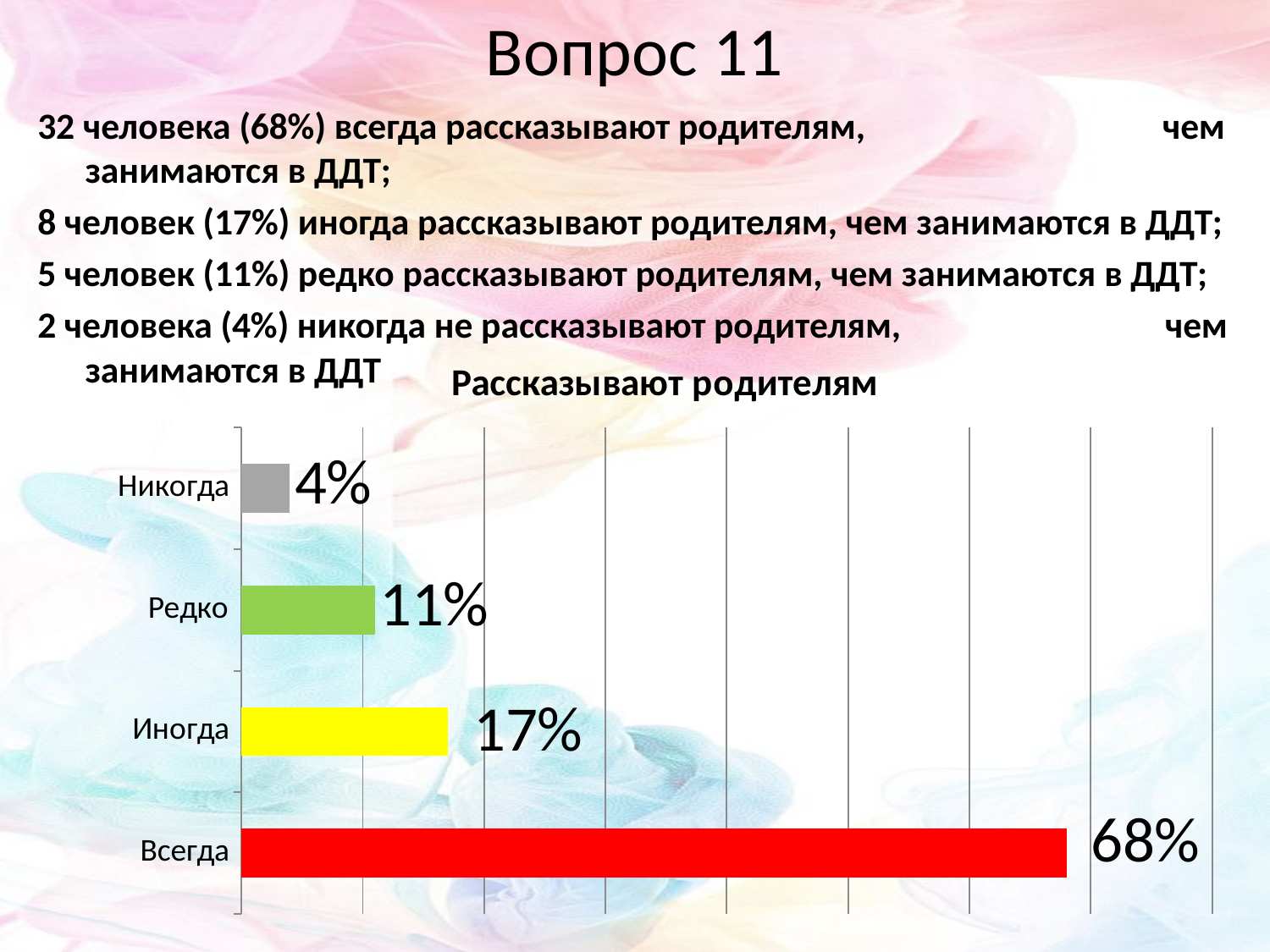
Which category has the lowest value? Никогда What is the value for Редко? 11% How many categories are shown in the chart? 4 What is the difference between the values for Редко and Никогда? 7% Which category has the highest value? Всегда What is the difference between the values for Всегда and Иногда? 51% What kind of chart is shown on the slide? bar chart What is the value for Всегда? 68% What is the value for Никогда? 4% Which is larger, the value for Иногда or the value for Редко? Иногда What is the title of the chart? Рассказывают родителям What is the value for Иногда? 17%